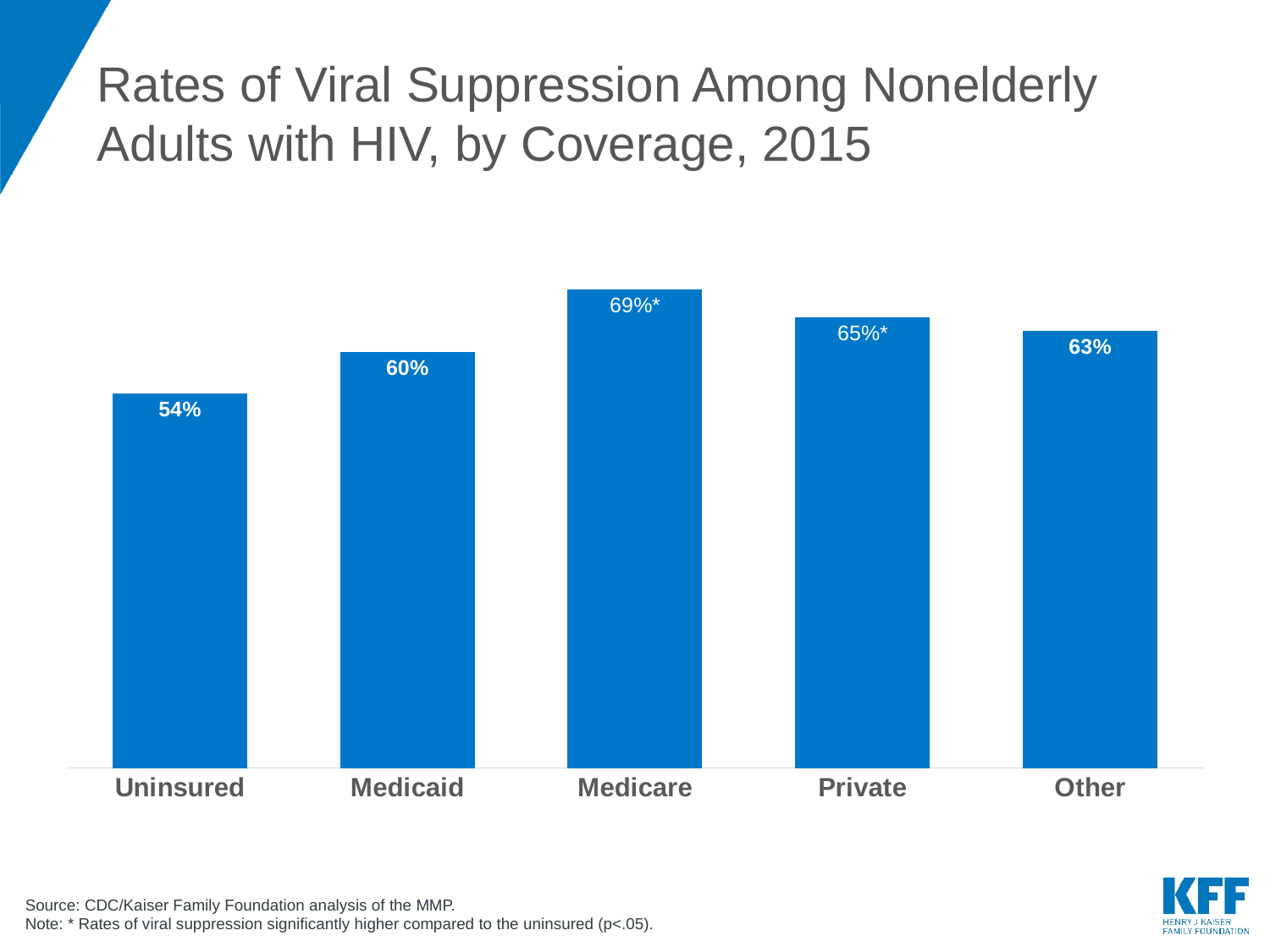
Which has a higher rate of viral suppression, Private or Medicaid? Private Which coverage categories are marked with an asterisk indicating significantly higher rates compared to the uninsured? Medicare and Private What is the rate of viral suppression for adults with Medicare coverage? 69% What is the rate of viral suppression for adults in the Other coverage category? 63% How many coverage categories are shown in the chart? 5 What is the rate of viral suppression for adults with Private coverage? 65% Which coverage category has the lowest rate of viral suppression? Uninsured What type of chart is shown on the slide? Bar chart What is the rate of viral suppression for adults with Medicaid coverage? 60% What is the difference in viral suppression rate between Medicare and Uninsured? 15 percentage points What is the rate of viral suppression for Uninsured adults? 54% Which coverage category has the highest rate of viral suppression? Medicare